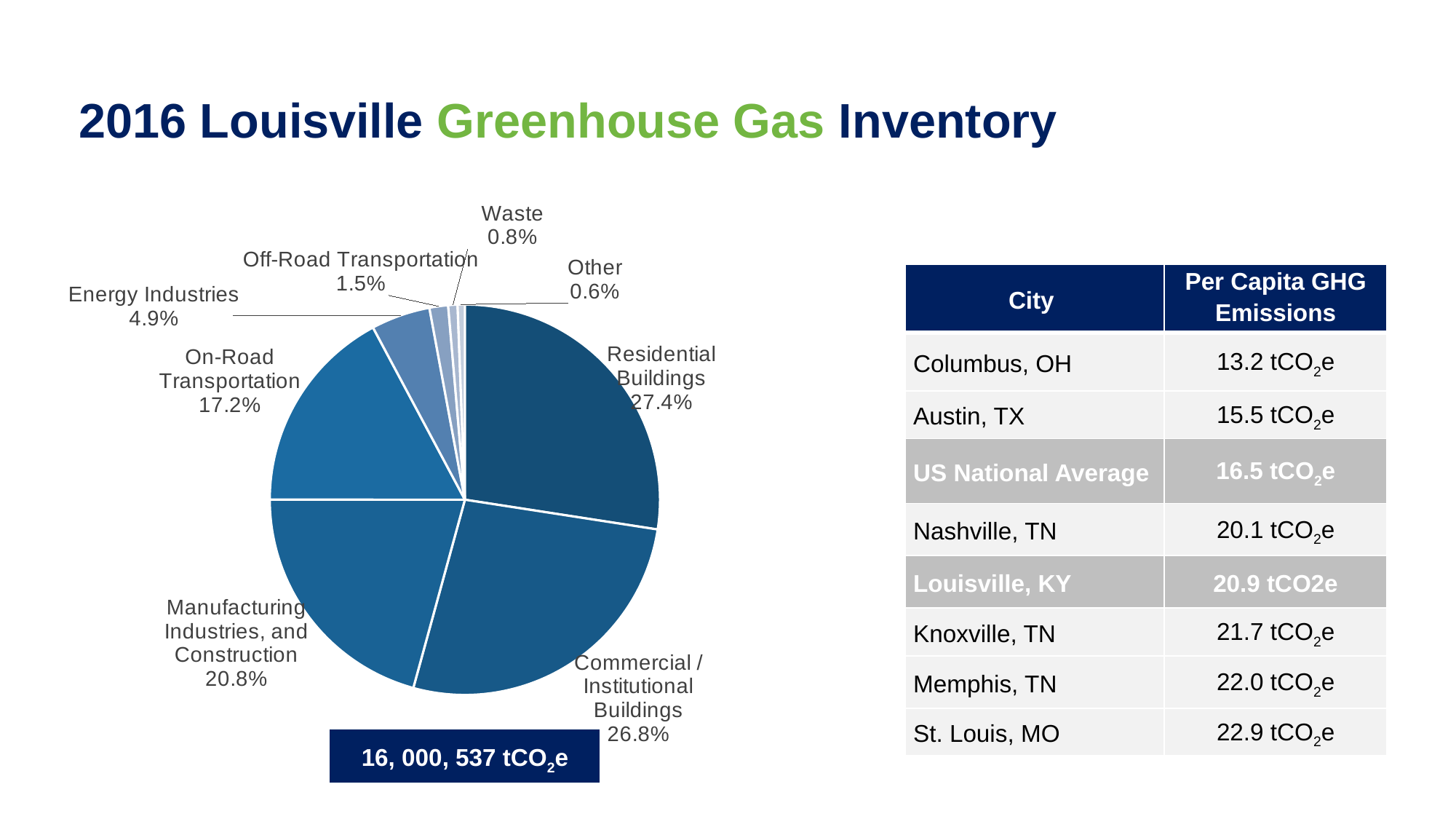
What is the combined share of Off-Road Transportation and Waste in the pie chart? 2.3% Which is larger in the pie chart, Manufacturing Industries, and Construction or On-Road Transportation? Manufacturing Industries, and Construction Which category has the smallest slice of the pie chart? Other What share of the pie chart is Energy Industries? 4.9% What kind of chart is shown on the slide? Pie chart How many categories are shown in the pie chart? 8 What total emissions value is shown in the box below the pie chart? 16, 000, 537 tCO2e What share of the pie chart is Waste? 0.8% What is the difference in percentage points between Residential Buildings and Commercial / Institutional Buildings? 0.6 Which category has the largest slice of the pie chart? Residential Buildings What share of the pie chart is On-Road Transportation? 17.2% What share of the pie chart is Residential Buildings? 27.4%